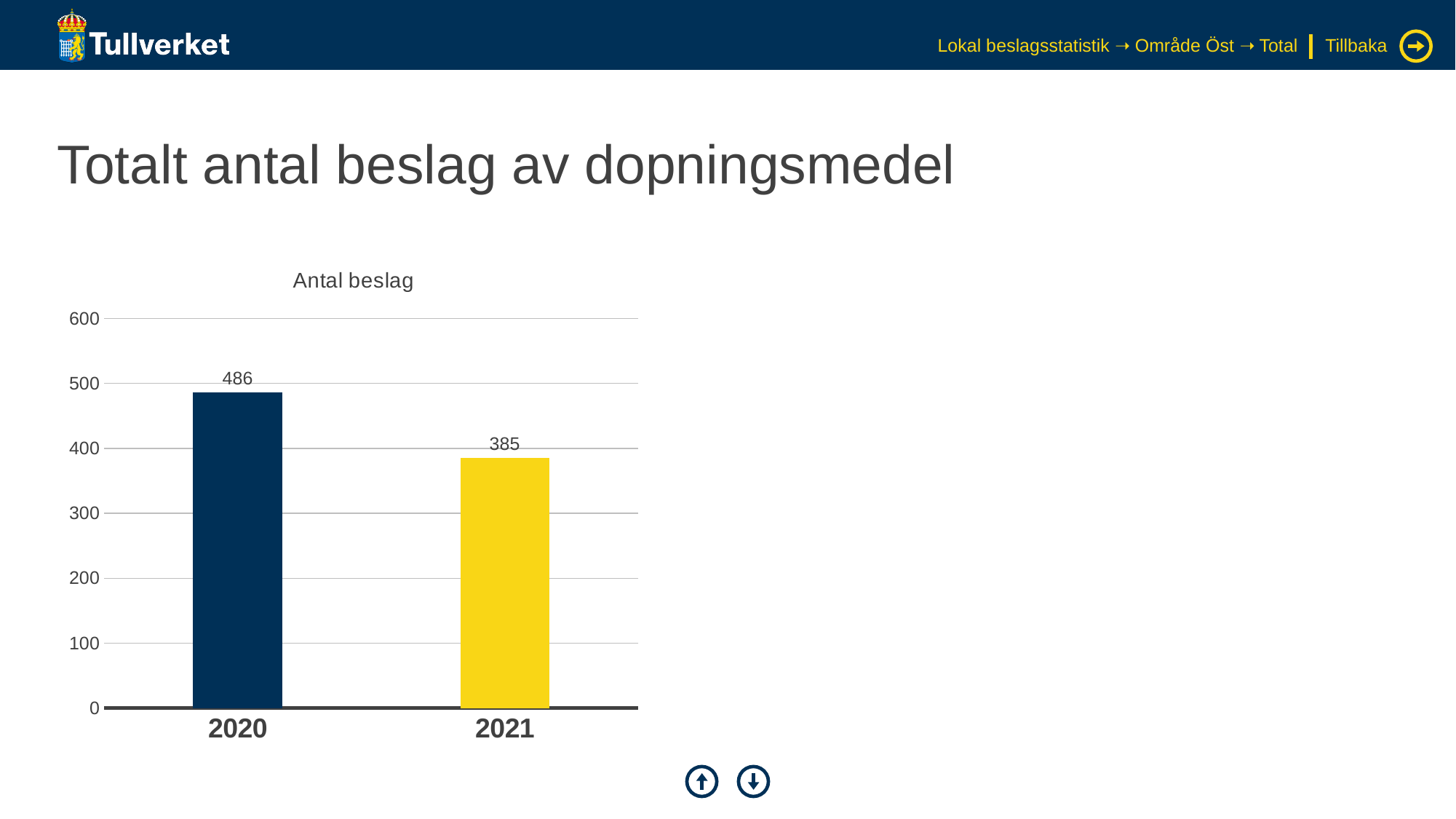
What is the value for 2021? 385 Is the value for 2021 greater or less than 400? less What is the title of the chart? Antal beslag Which year has the lowest number of seizures? 2021 How many years are shown on the x axis? 2 What kind of chart is shown on the slide? bar chart What is the value for 2020? 486 Which is larger, the value for 2020 or the value for 2021? 2020 What is the difference between the values for 2020 and 2021? 101 Do the values rise or fall from 2020 to 2021? fall Which year has the highest number of seizures? 2020 Is the value for 2020 greater or less than 400? greater